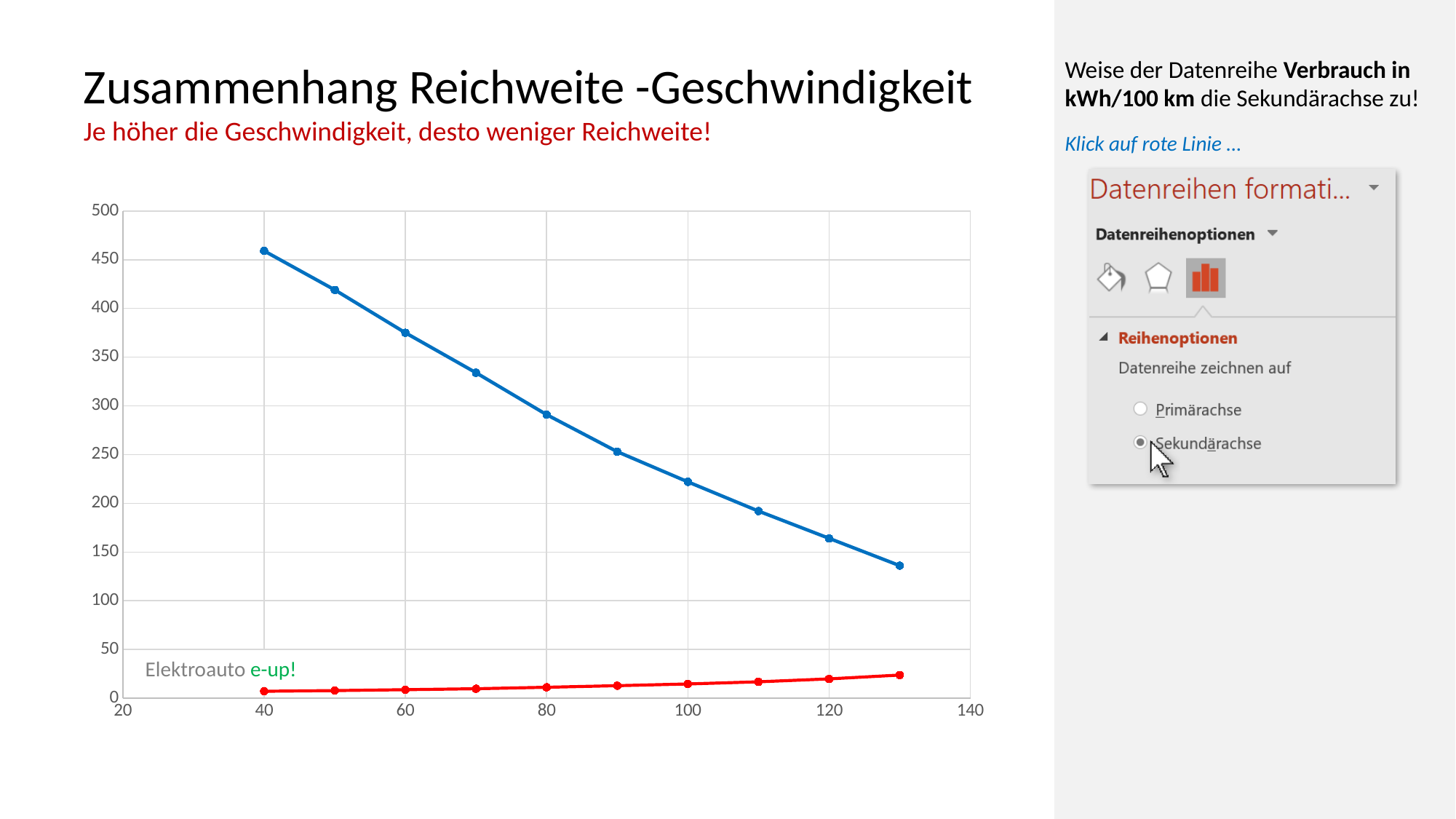
Does the red line rise or fall as the x-axis value increases from 40 to 130? rise How many lines are plotted in the chart? 2 How many data points does the blue line have? 10 At which x-axis value does the blue line reach its lowest point? 130 What text label is shown inside the chart area near the bottom left? Elektroauto e-up! Is the value of the red line at x = 130 greater or less than 50? less At which x-axis value does the blue line reach its highest point? 40 Is the value of the blue line at x = 100 greater or less than 200? greater Is the value of the blue line at x = 130 greater or less than 150? less Does the blue line rise or fall as the x-axis value increases from 40 to 130? fall What kind of chart is shown on the slide? line chart